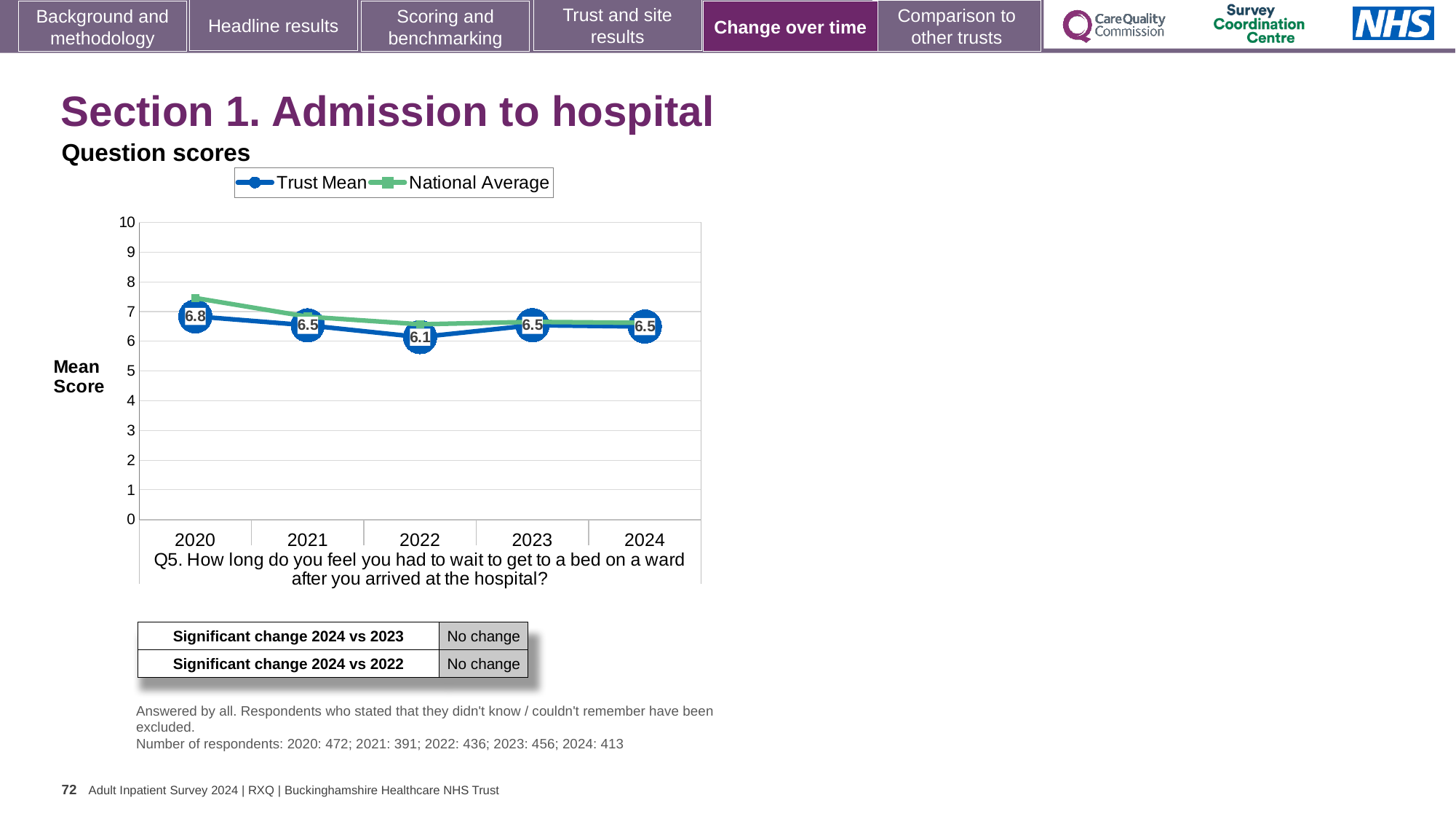
How many years are shown on the x axis of the chart? 5 What is the label of the y axis of the chart? Mean Score What is the Trust Mean score for 2020? 6.8 What is the difference between the Trust Mean score in 2020 and in 2022? 0.7 What is the Trust Mean score for 2022? 6.1 What kind of chart is shown on the slide? Line chart Which is larger, the Trust Mean score in 2021 or in 2022? 2021 In which year is the Trust Mean score lowest? 2022 How many series does the chart legend list? 2 Is the National Average value for 2020 greater or less than 7? greater In which year is the Trust Mean score highest? 2020 What is the Trust Mean score for 2024? 6.5